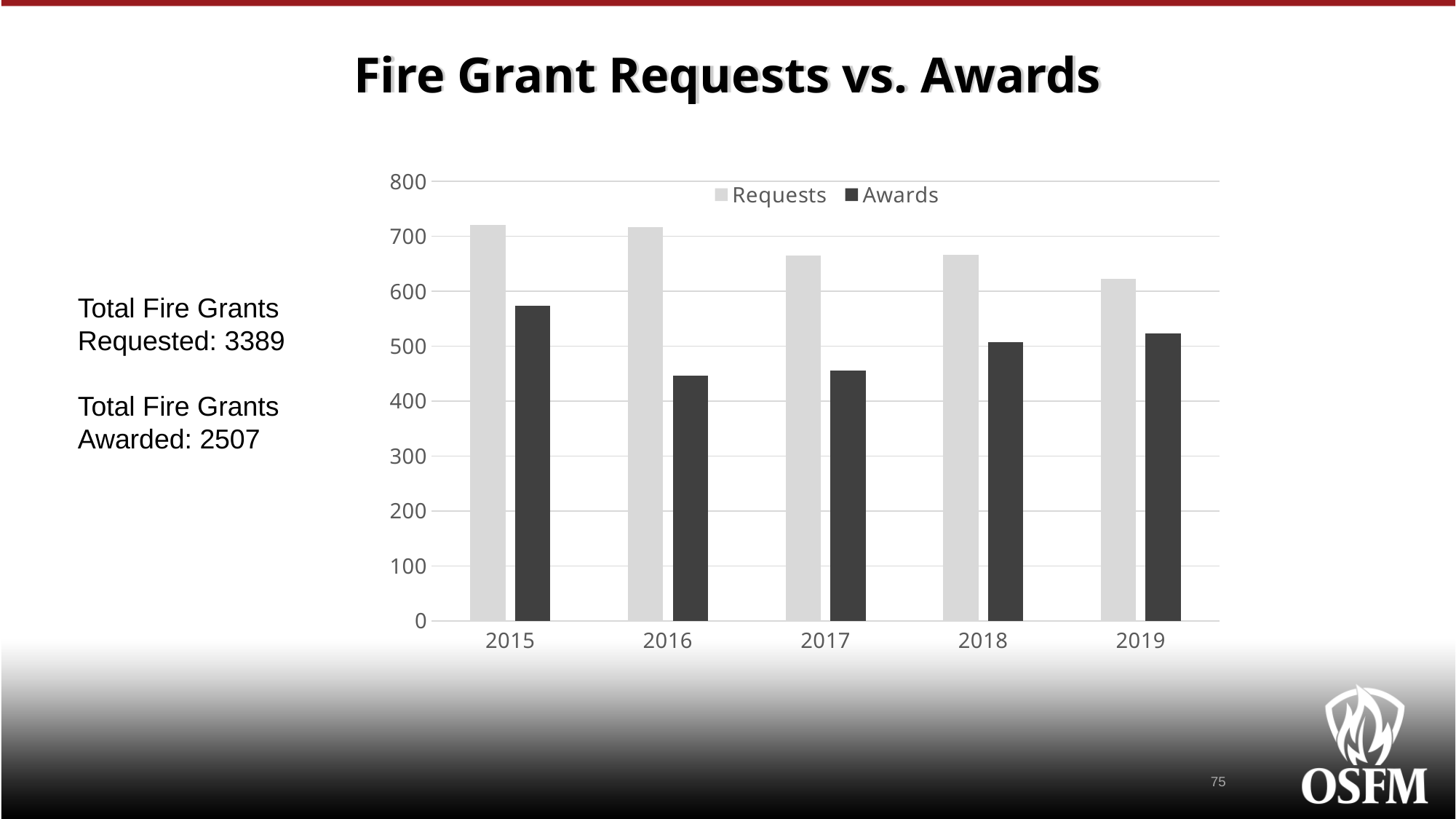
What are the two series named in the chart legend? Requests and Awards In which year is the Awards bar the highest? 2015 Is the Requests value for 2015 greater or less than 700? greater Is the Awards value for 2016 greater or less than 500? less How many years are shown on the x axis of the chart? 5 Do the Requests values generally rise or fall from 2015 to 2019? fall What kind of chart is shown on the slide? bar chart What is the title of the chart on the slide? Fire Grant Requests vs. Awards How many series does the chart legend list? 2 Is the Awards value for 2019 greater or less than 500? greater In which year is the Requests bar the lowest? 2019 Which is larger, the Requests value for 2015 or the Requests value for 2019? 2015